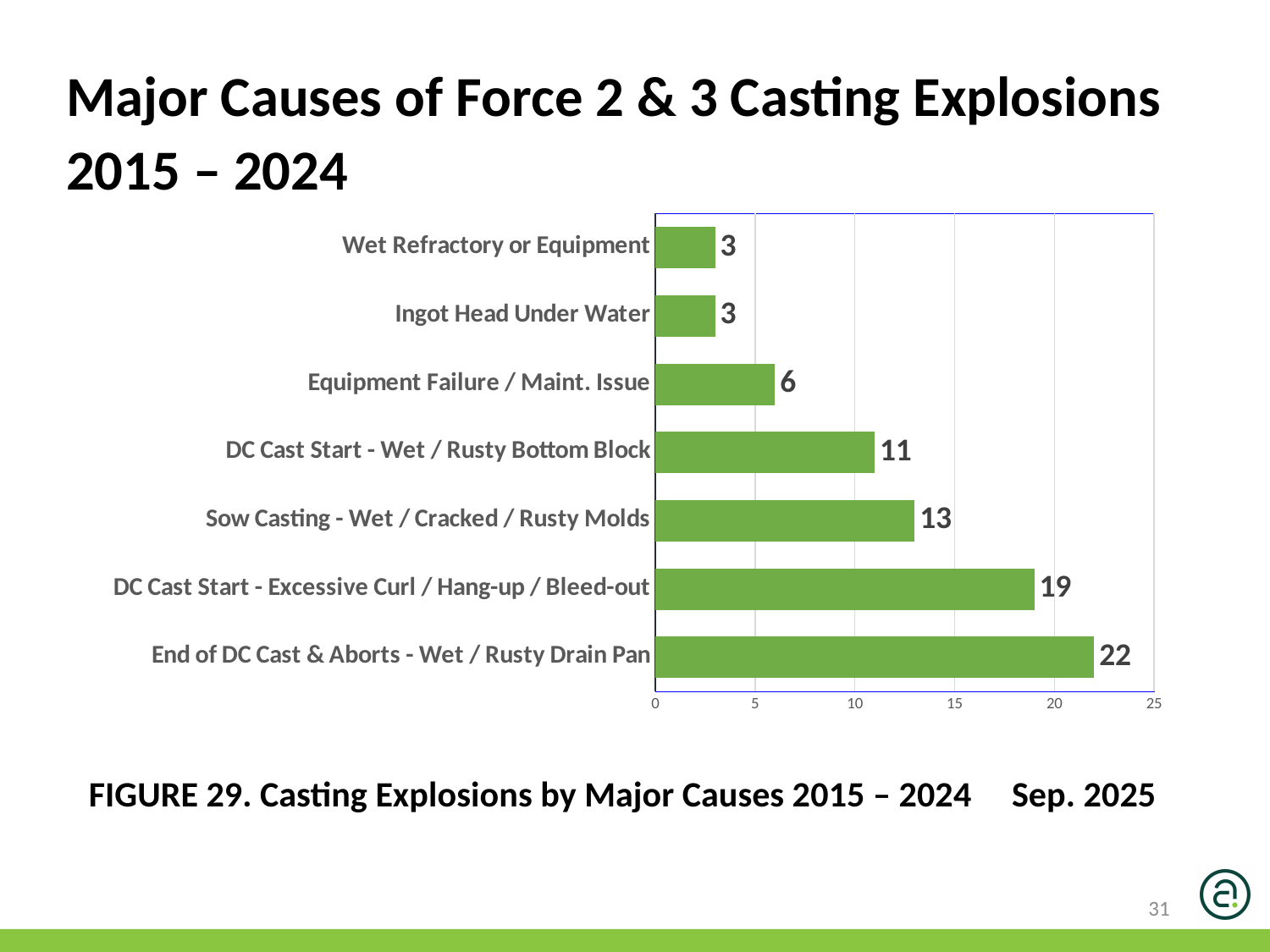
Is the value for DC Cast Start - Wet / Rusty Bottom Block greater or less than 10? greater How many categories are shown on the chart? 7 What is the value for Equipment Failure / Maint. Issue? 6 What is the value for End of DC Cast & Aborts - Wet / Rusty Drain Pan? 22 Which is larger, the value for DC Cast Start - Excessive Curl / Hang-up / Bleed-out or the value for Sow Casting - Wet / Cracked / Rusty Molds? DC Cast Start - Excessive Curl / Hang-up / Bleed-out What is the difference between the values for End of DC Cast & Aborts - Wet / Rusty Drain Pan and DC Cast Start - Excessive Curl / Hang-up / Bleed-out? 3 What is the figure caption below the chart? FIGURE 29. Casting Explosions by Major Causes 2015 – 2024 What is the lowest value shown on the chart? 3 What is the difference between the values for Sow Casting - Wet / Cracked / Rusty Molds and DC Cast Start - Wet / Rusty Bottom Block? 2 What kind of chart is shown on the slide? Bar chart Which category has the highest value? End of DC Cast & Aborts - Wet / Rusty Drain Pan What is the value for Sow Casting - Wet / Cracked / Rusty Molds? 13